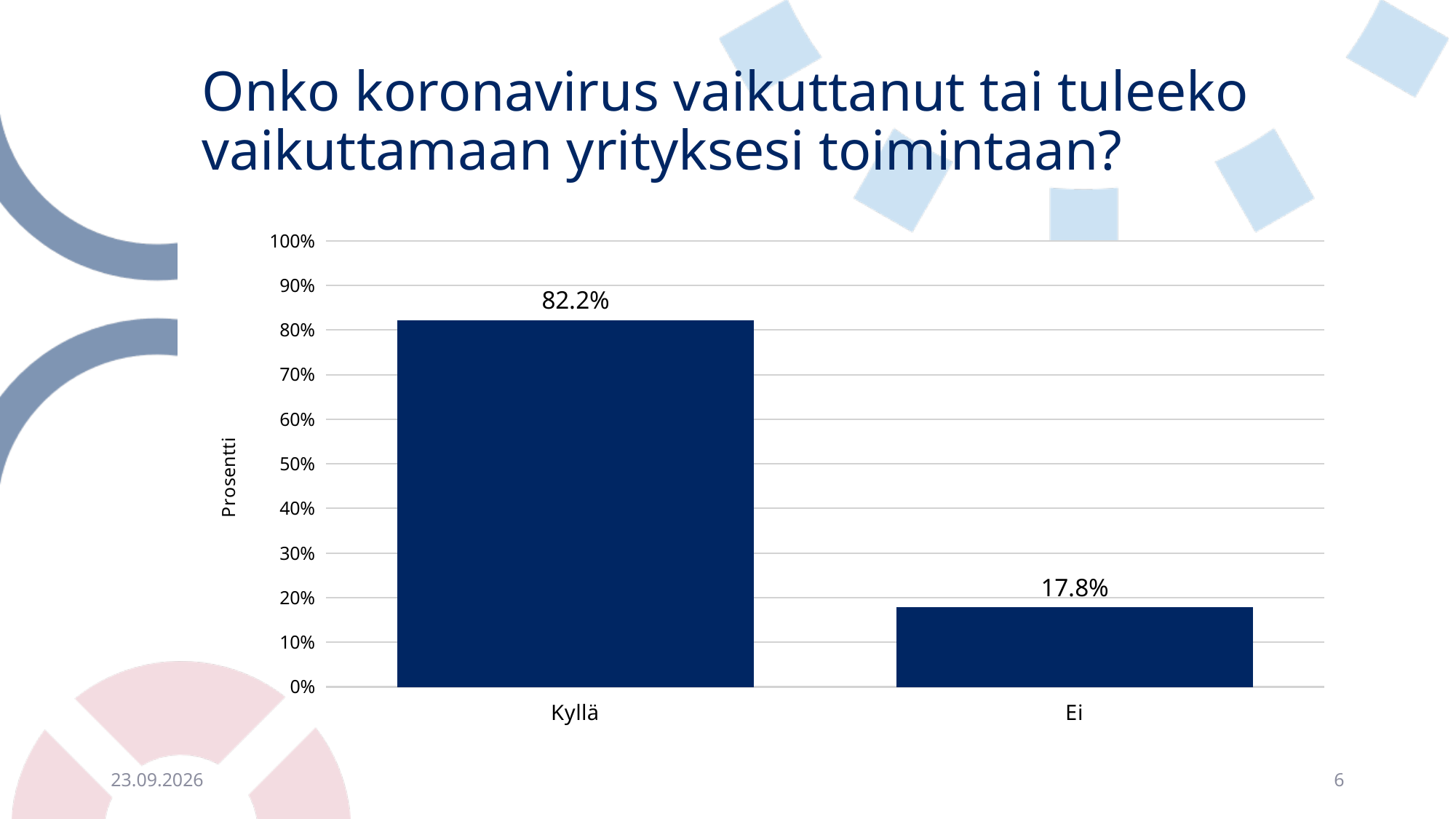
What is the difference between the values for Kyllä and Ei? 64.4% Is the value for Kyllä greater or less than 80%? greater What is the value for Ei? 17.8% What is the label of the vertical axis? Prosentti What is the total of the values for Kyllä and Ei? 100% Which category has the highest value? Kyllä Which category has the lowest value? Ei How many categories are shown on the x axis? 2 Which is larger, the value for Kyllä or the value for Ei? Kyllä Is the value for Ei greater or less than 20%? less What is the value for Kyllä? 82.2% What kind of chart is shown on the slide? bar chart